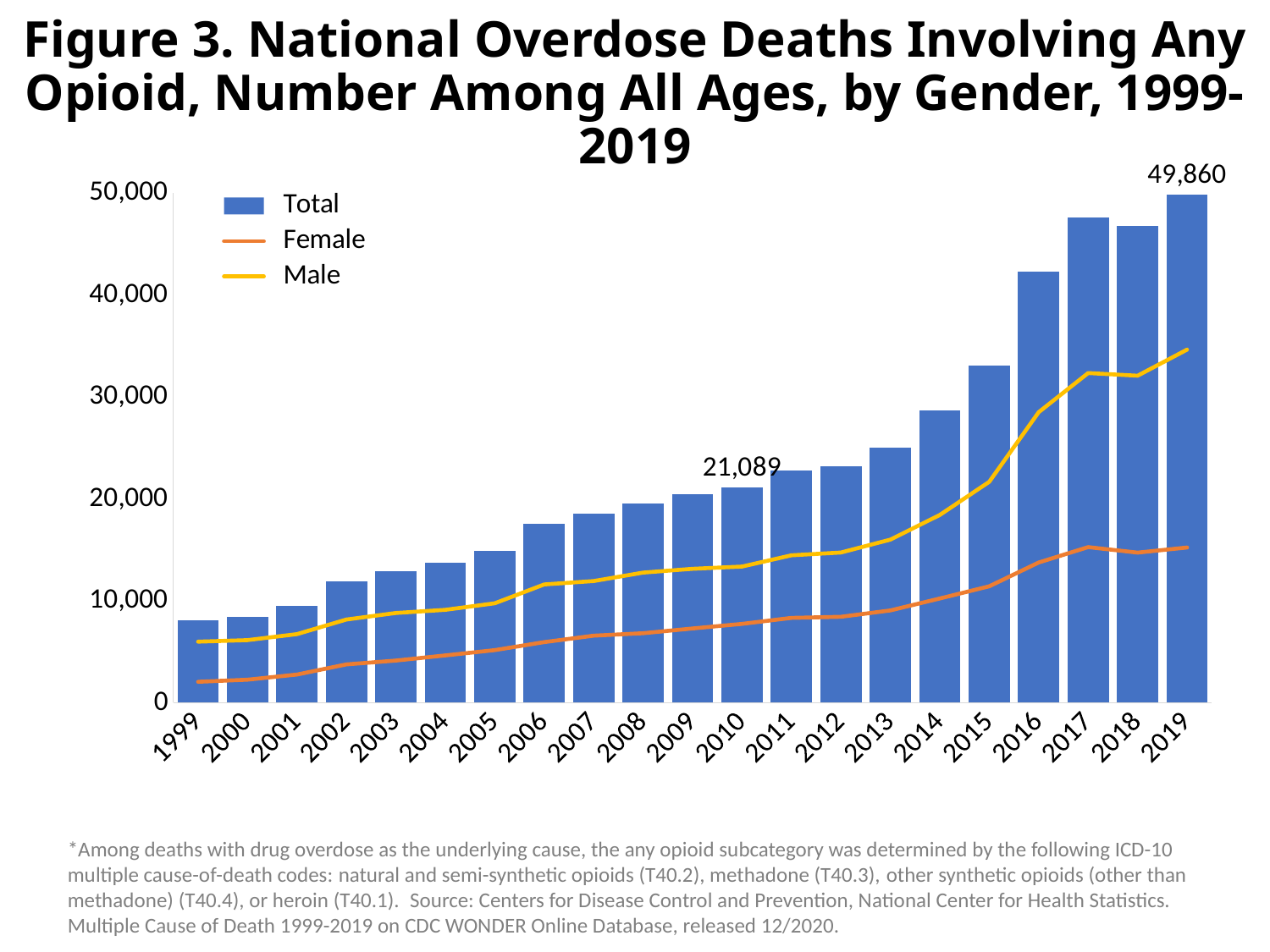
In 2019, which is larger, the Male value or the Female value? Male What is the Total number of overdose deaths involving any opioid in 2010? 21,089 Which year has the lowest Total bar? 1999 By how much did the Total number of deaths increase from 2010 to 2019? 28,771 How many years are shown on the x axis? 21 What colour is the Male line in the legend? yellow How many series does the legend list? 3 What is the Total number of overdose deaths involving any opioid in 2019? 49,860 Do the Total values generally rise or fall from 1999 to 2019? rise What kind of chart is used to show the Total series? bar chart Is the Total value for 2016 greater or less than 40,000? greater Which year has the highest Total bar? 2019